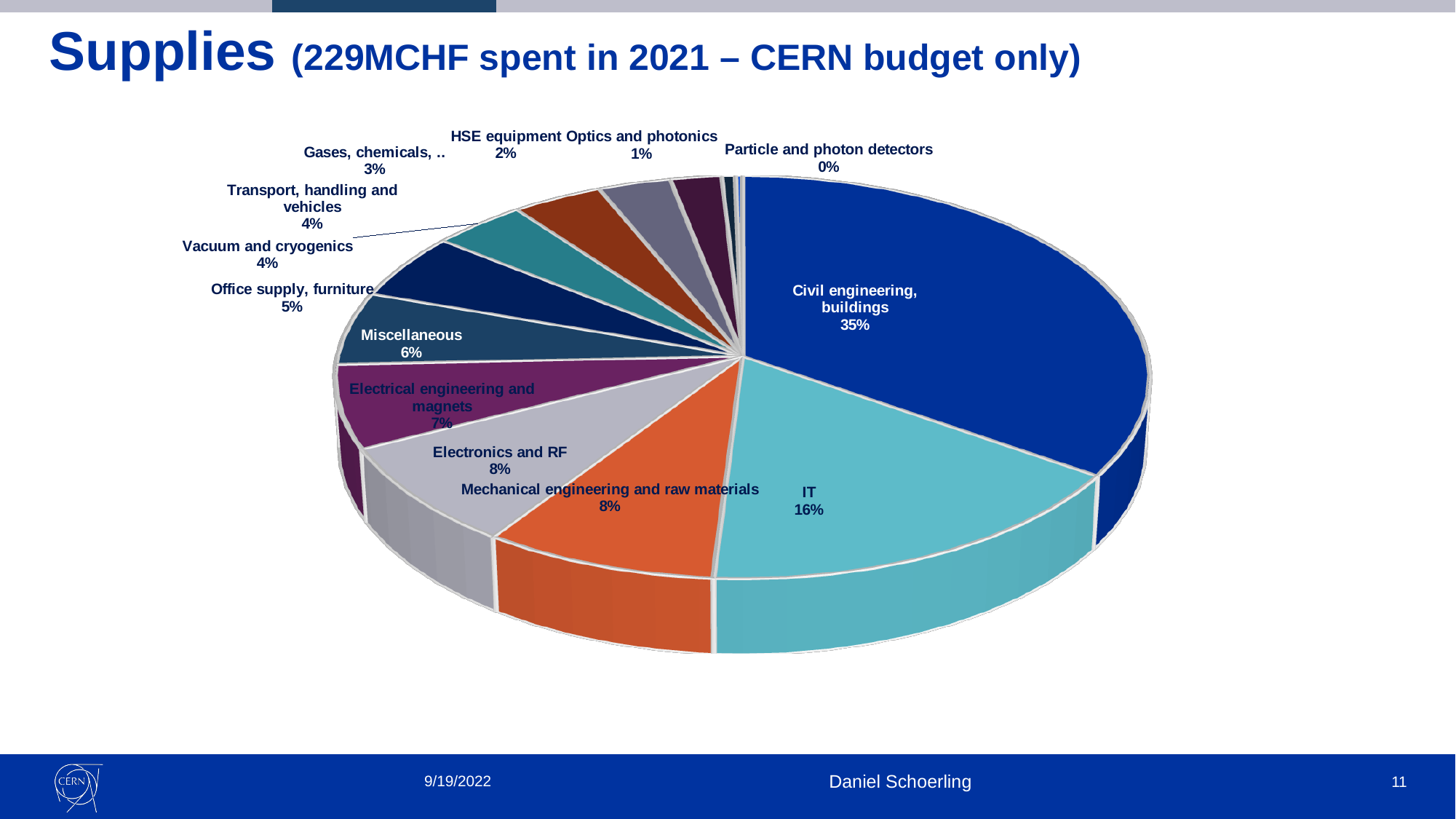
Which is larger, the share for Miscellaneous or the share for Vacuum and cryogenics? Miscellaneous How many categories are shown in the pie chart? 13 What percentage is shown for Office supply, furniture? 5% What is the difference in percentage points between Civil engineering, buildings and IT? 19 What percentage is shown for Miscellaneous? 6% What percentage is shown for Electrical engineering and magnets? 7% What share of supplies spending goes to IT? 16% What share of supplies spending goes to Civil engineering, buildings? 35% According to the slide title, how much was spent on supplies in 2021? 229MCHF Which category has the smallest share of the pie? Particle and photon detectors What kind of chart is shown on the slide? pie chart Which category has the largest share of the pie? Civil engineering, buildings